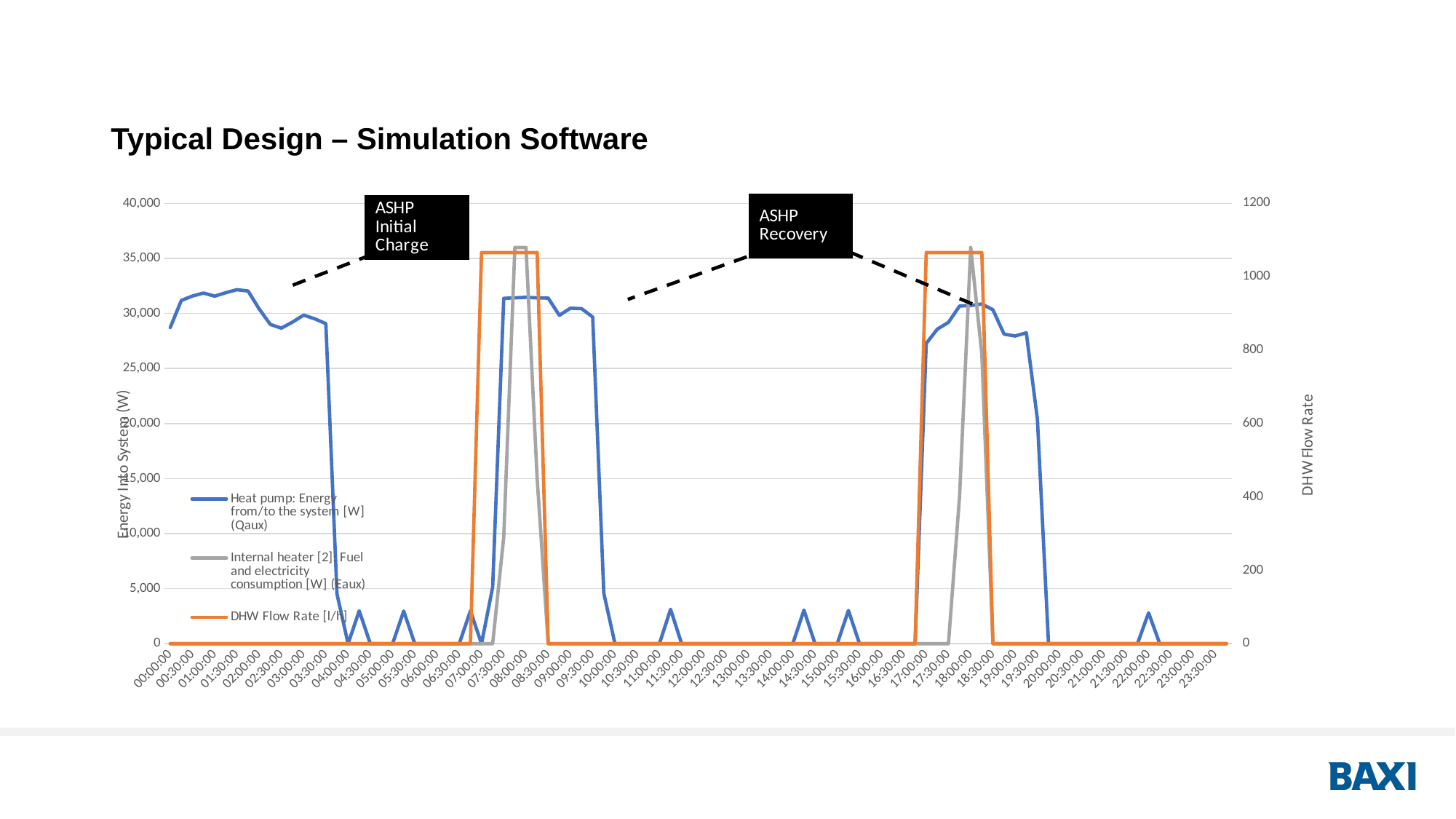
Is the DHW Flow Rate [l/h] at 07:30:00 greater or less than 1000 on the right axis? greater Is the value of Heat pump: Energy from/to the system [W] (Qaux) at 12:00:00 greater or less than 5,000? less Which is larger for Heat pump: Energy from/to the system [W] (Qaux): the value at 02:00:00 or the value at 12:00:00? 02:00:00 Is the value of Internal heater [2]: Fuel and electricity consumption [W] (Eaux) at 08:00:00 greater or less than 30,000? greater What is the title of the left vertical axis? Energy Into System (W) How many series does the legend list? 3 How many time points are labelled along the x axis? 48 What do the two black annotation boxes on the chart say? ASHP Initial Charge and ASHP Recovery Which is larger for DHW Flow Rate [l/h]: the value at 07:30:00 or the value at 13:00:00? 07:30:00 What kind of chart is shown on the slide? Line chart